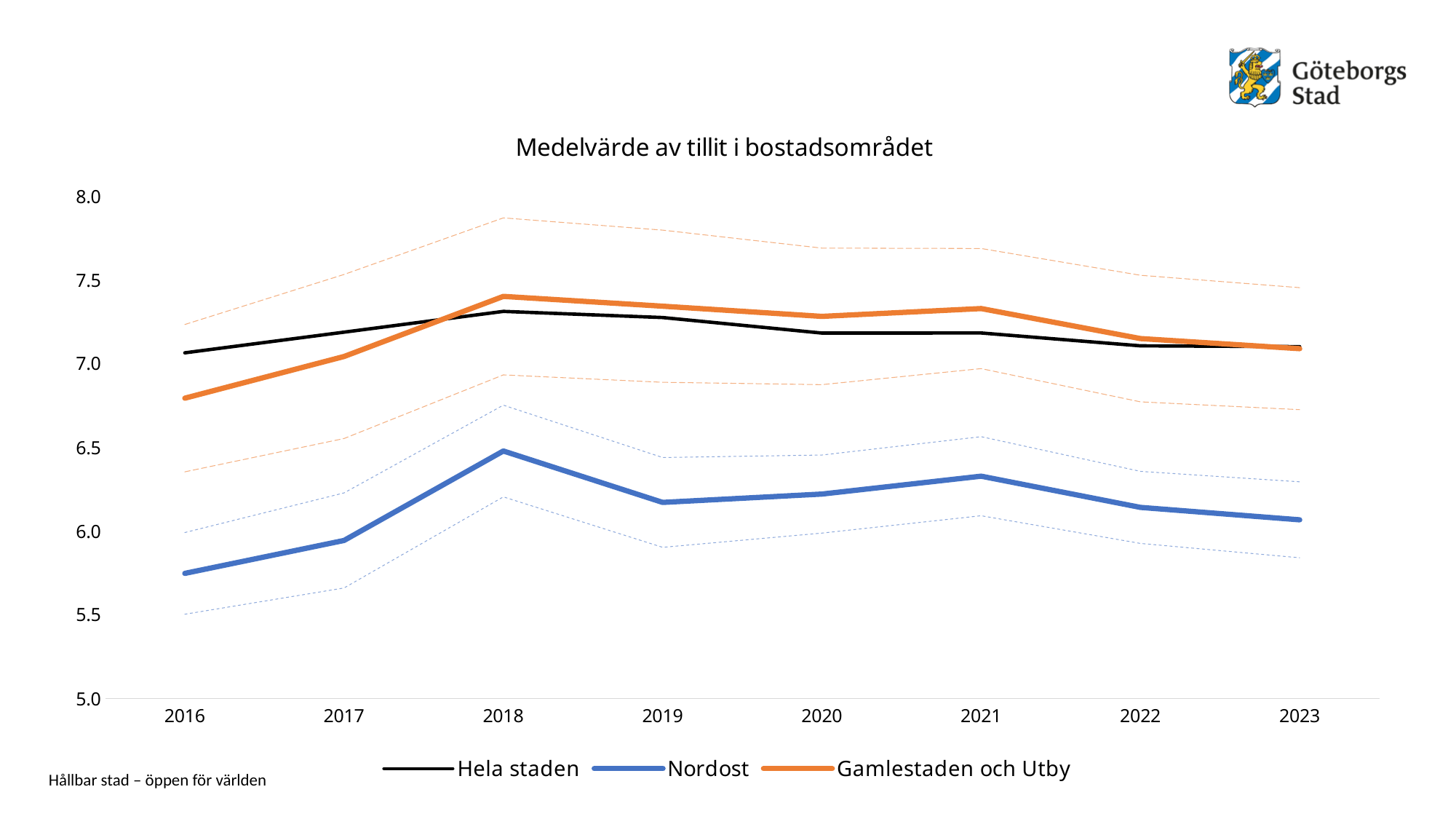
What is the title of the chart? Medelvärde av tillit i bostadsområdet How many years are shown on the x axis? 8 How many series does the legend list? 3 In 2016, which is larger: Hela staden or Gamlestaden och Utby? Hela staden Which series is drawn in orange? Gamlestaden och Utby Is the value for Nordost in 2016 greater or less than 6.0? less Is the value for Gamlestaden och Utby in 2016 greater or less than 7.0? less In which year does the Nordost series have its lowest value? 2016 In which year does the Gamlestaden och Utby series have its lowest value? 2016 Does the Nordost series rise or fall from 2021 to 2023? fall What kind of chart is shown on the slide? line chart In which year does the Nordost series reach its highest value? 2018